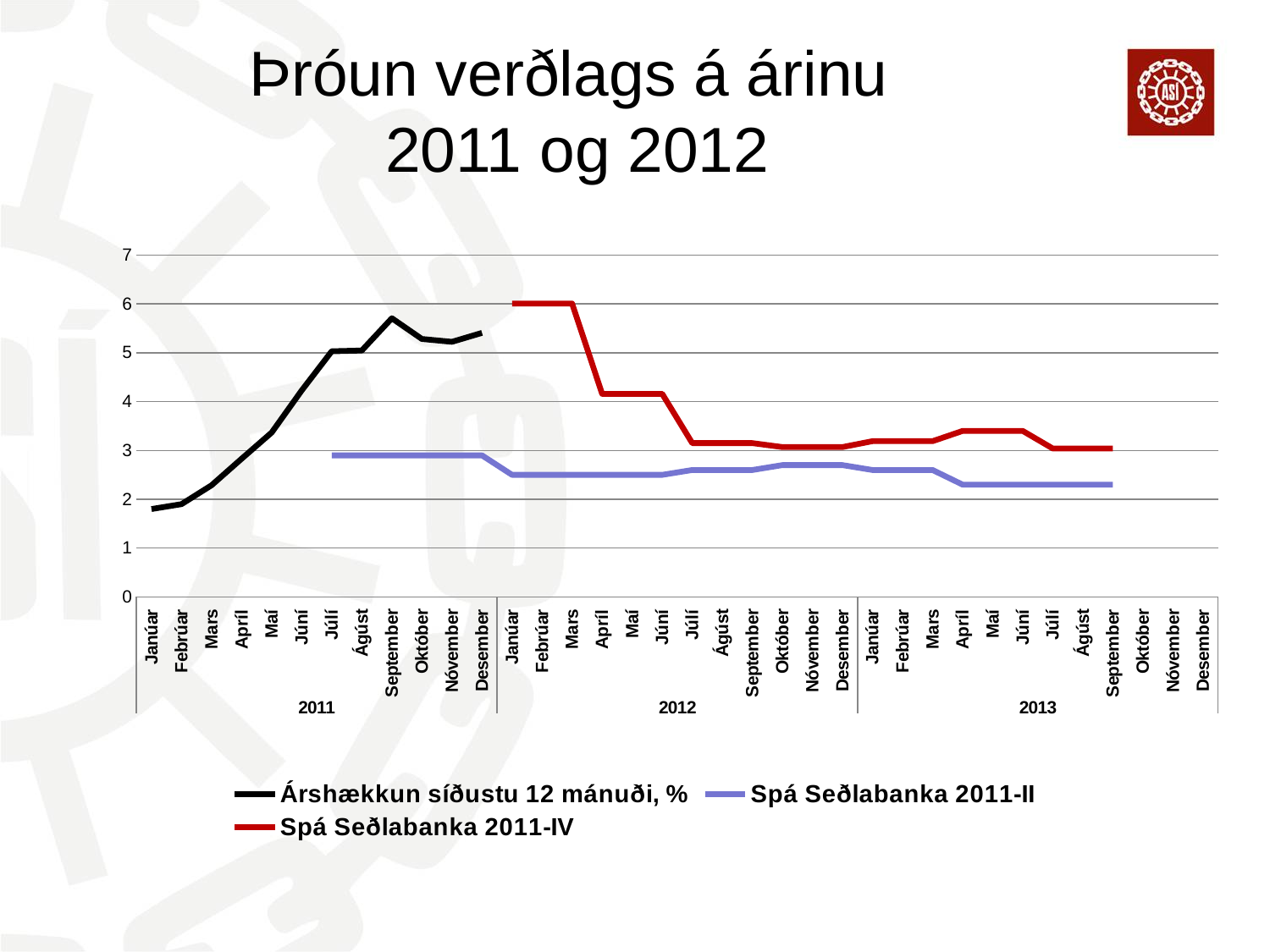
Does the 'Árshækkun síðustu 12 mánuði, %' line rise or fall from Janúar 2011 to September 2011? rise Is the value of 'Spá Seðlabanka 2011-II' in Janúar 2012 greater or less than 3? less Does the 'Spá Seðlabanka 2011-IV' line rise or fall from Mars 2012 to Júlí 2012? fall In which month of 2011 does the 'Árshækkun síðustu 12 mánuði, %' line reach its highest point? September Which year groups are shown along the x axis? 2011, 2012, 2013 What kind of chart is shown on the slide? line chart Is the value of 'Spá Seðlabanka 2011-IV' in Janúar 2012 greater or less than 5? greater How many series does the legend list? 3 Which colour is used for the series 'Spá Seðlabanka 2011-IV'? red In which month is the 'Árshækkun síðustu 12 mánuði, %' line at its lowest? Janúar 2011 In Janúar 2012, which series is higher: 'Spá Seðlabanka 2011-IV' or 'Spá Seðlabanka 2011-II'? Spá Seðlabanka 2011-IV Is the value of 'Árshækkun síðustu 12 mánuði, %' in September 2011 greater or less than 5? greater